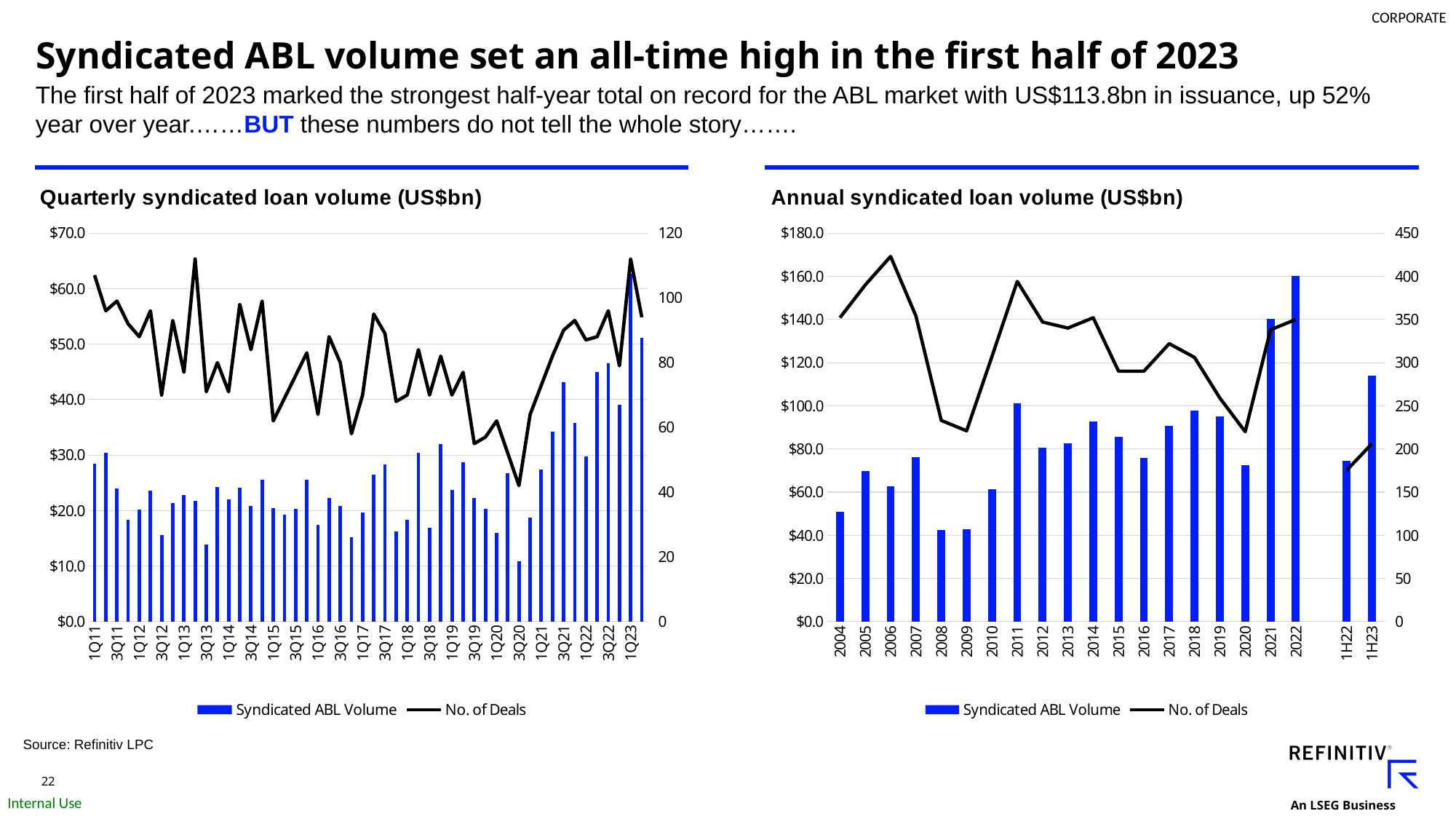
On the Annual syndicated loan volume chart, is the Syndicated ABL Volume bar for 2022 greater or less than $140.0? greater What kind of chart is the Annual syndicated loan volume chart? combination bar and line chart On the Annual syndicated loan volume chart, is the Syndicated ABL Volume bar for 2004 greater or less than $60.0? less On the Annual syndicated loan volume chart, how many categories are shown on the x axis? 21 How many series does the legend of the Quarterly syndicated loan volume chart list? 2 On the Annual syndicated loan volume chart, which is larger, the Syndicated ABL Volume bar for 2010 or for 2011? 2011 On the Annual syndicated loan volume chart, in which year does the No. of Deals line reach its highest point? 2006 On the Quarterly syndicated loan volume chart, which quarter has the tallest Syndicated ABL Volume bar? 1Q23 On the Quarterly syndicated loan volume chart, is the Syndicated ABL Volume bar for 3Q20 greater or less than $20.0? less On the Annual syndicated loan volume chart, which year has the tallest Syndicated ABL Volume bar? 2022 On the Annual syndicated loan volume chart, which is larger, the Syndicated ABL Volume bar for 1H22 or for 1H23? 1H23